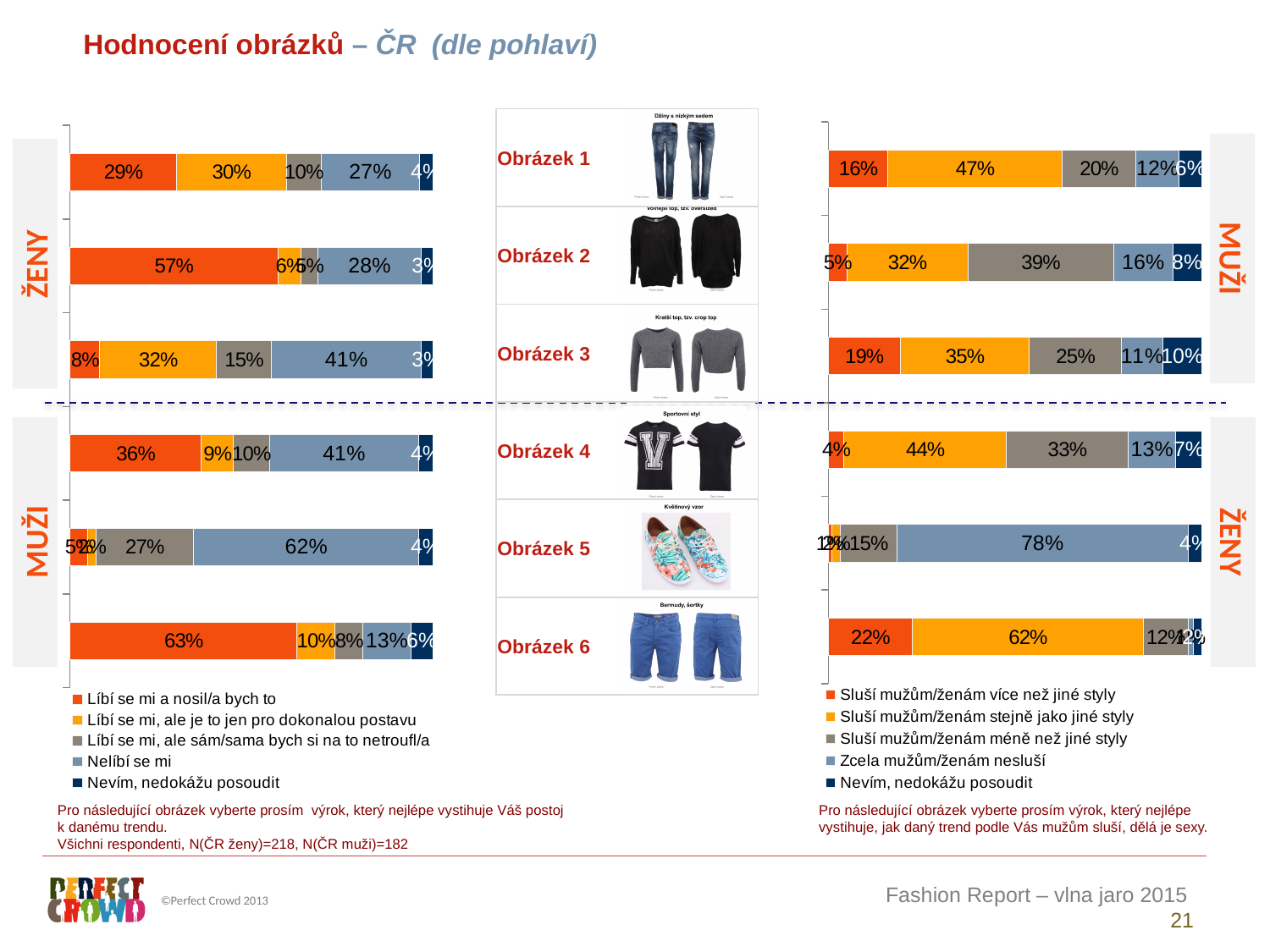
What type of chart is used on the left side of the slide? Stacked bar chart How many entries does the legend of the left chart list? 5 In the right chart, what share of men chose "Sluší mužům/ženám stejně jako jiné styly" for Obrázek 1? 47% In the left chart, what share of men chose "Nelíbí se mi" for Obrázek 5? 62% In the left chart, what share of women chose "Líbí se mi a nosil/a bych to" for Obrázek 2? 57% In the left chart, which of the three men's rows (Obrázek 4, 5, 6) has the highest share for "Líbí se mi a nosil/a bych to"? Obrázek 6 In the right chart, is the "Sluší mužům/ženám méně než jiné styly" share for Obrázek 2 (men) larger or smaller than for Obrázek 3 (men)? larger In the left chart, which of the three women's rows (Obrázek 1, 2, 3) has the lowest share for "Líbí se mi a nosil/a bych to"? Obrázek 3 In the right chart, what share of women chose "Sluší mužům/ženám stejně jako jiné styly" for Obrázek 6? 62% In the right chart, what share of women chose "Zcela mužům/ženám nesluší" for Obrázek 5? 78% How many images (Obrázek rows) are evaluated on the slide? 6 In the left chart, what is the difference between the "Nelíbí se mi" share for Obrázek 3 (women) and for Obrázek 1 (women)? 14%